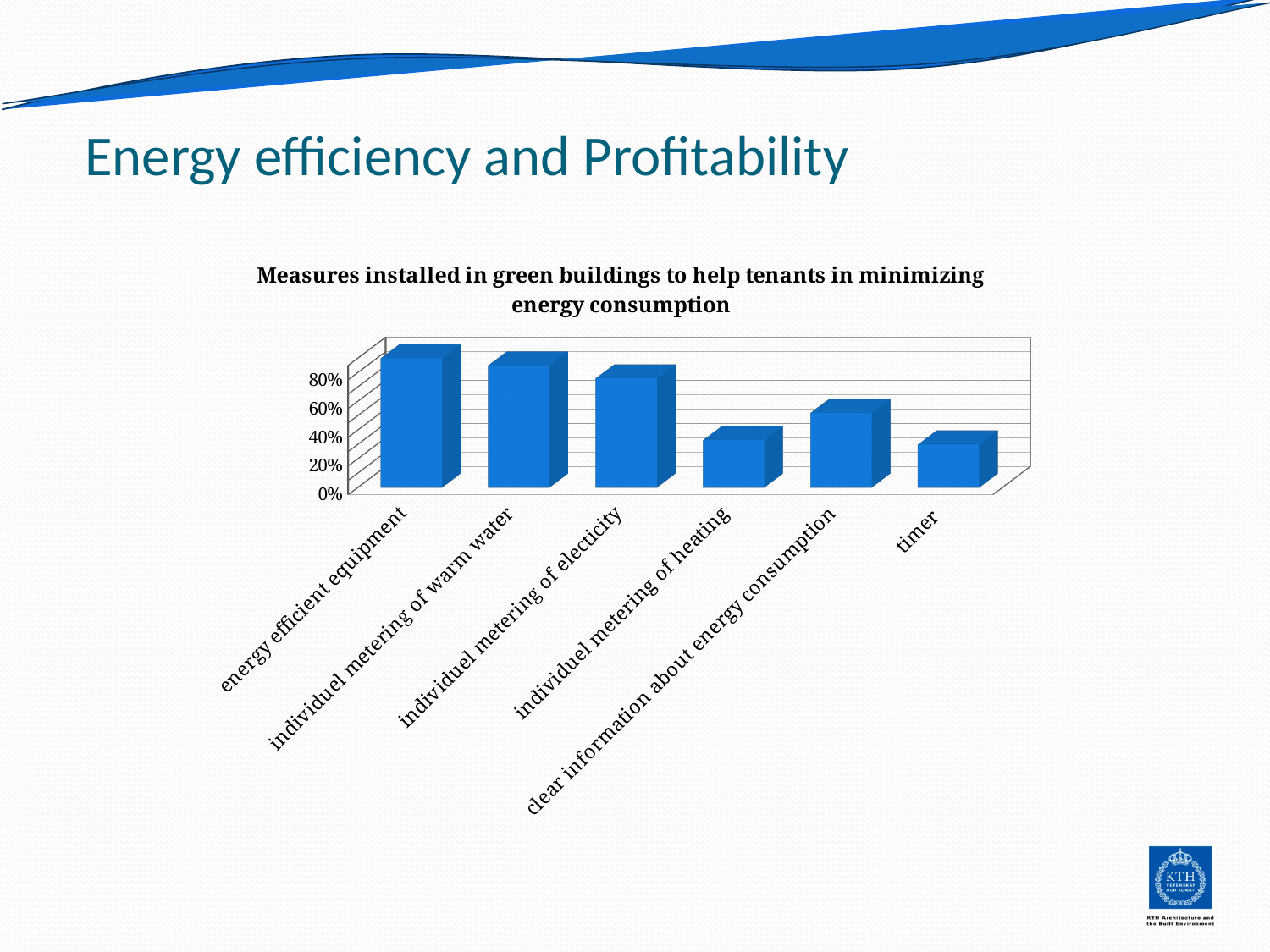
How many categories (measures) are shown on the x axis of the chart? 6 Which is larger: the value for clear information about energy consumption or the value for timer? clear information about energy consumption Is the value for energy efficient equipment greater or less than 80%? greater Which is larger: the value for individuel metering of warm water or the value for individuel metering of heating? individuel metering of warm water Is the value for individuel metering of electicity greater or less than 60%? greater What kind of chart is shown on the slide? bar chart What is the highest tick label shown on the vertical axis of the chart? 80% Is the value for timer greater or less than 40%? less Which measure has the highest value in the chart? energy efficient equipment What is the title of the chart? Measures installed in green buildings to help tenants in minimizing energy consumption